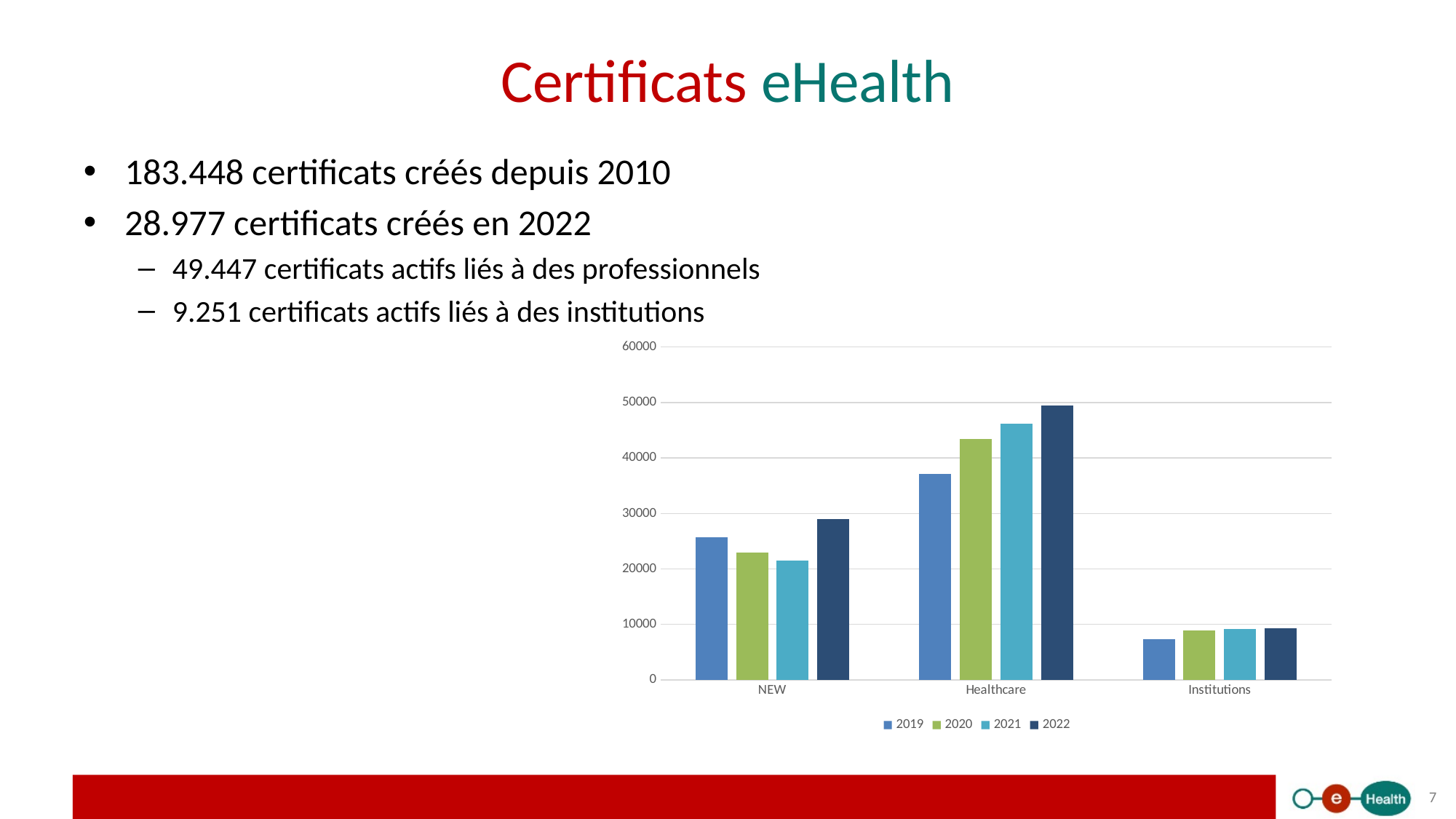
Within the Healthcare category, which year has the highest value? 2022 In the NEW category, which is larger: the value for 2019 or the value for 2022? 2022 Which category has the lowest bars in the chart? Institutions Is the value for 2019 in the Healthcare category greater or less than 30000? greater Which category has the highest bars in the chart? Healthcare What kind of chart is shown on the slide? bar chart How many series does the chart legend list? 4 Within the Institutions category, which year has the lowest value? 2019 How many categories are shown on the x axis of the chart? 3 In the Healthcare category, do the values rise or fall from 2019 to 2022? rise Is the value for 2021 in the NEW category greater or less than 20000? greater Is the value for 2019 in the Institutions category greater or less than 10000? less